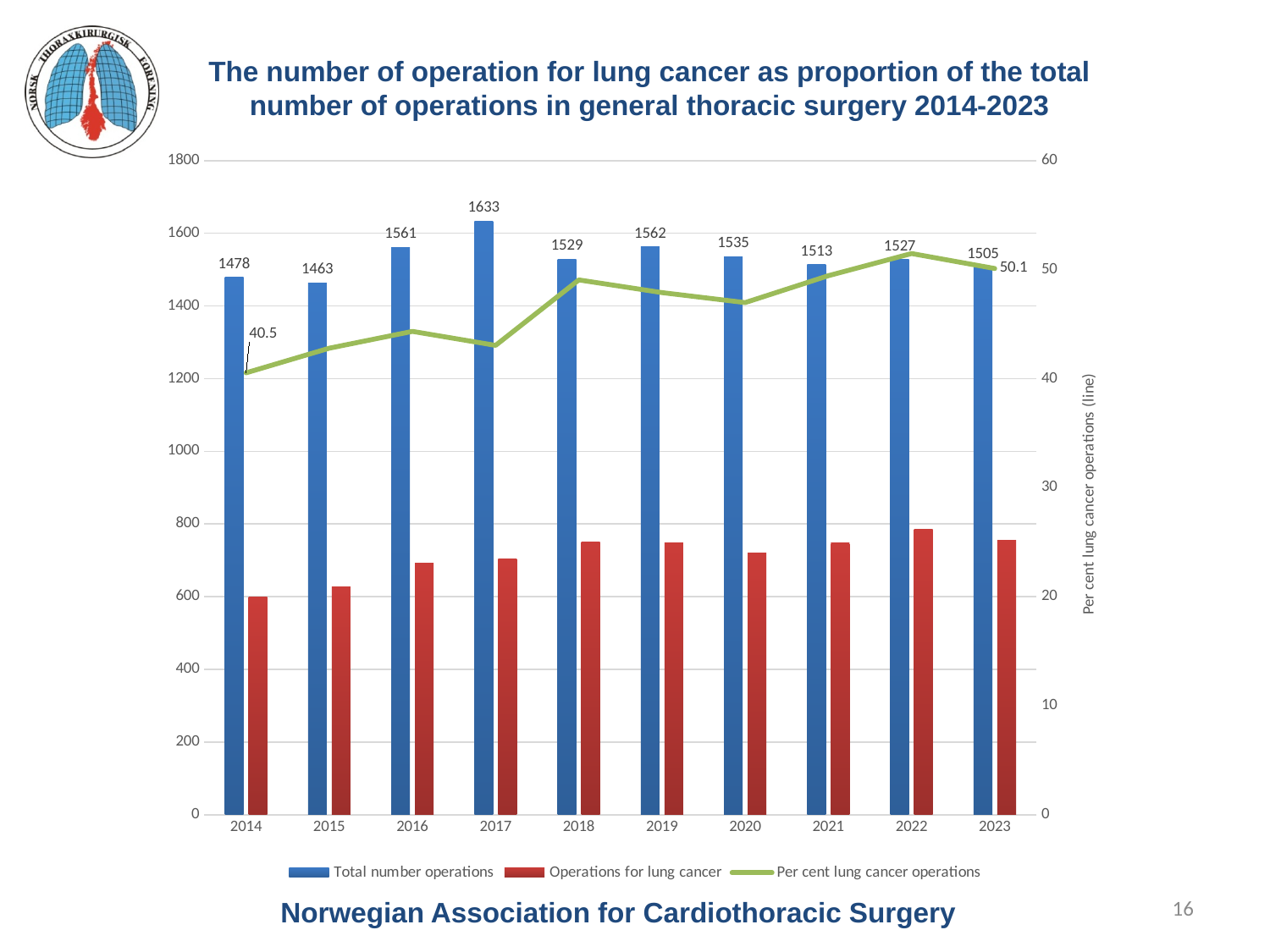
Which year had the lowest total number of operations? 2015 What was the total number of operations in 2017? 1633 Is the number of operations for lung cancer in 2022 greater or less than 600? greater How many series does the legend list? 3 How many years are shown on the x axis? 10 What is the difference between the total number of operations in 2017 and in 2014? 155 What per cent of operations were for lung cancer in 2023? 50.1 Which series is plotted as a line rather than bars? Per cent lung cancer operations Which year had the highest total number of operations? 2017 What was the total number of operations in 2023? 1505 What per cent of operations were for lung cancer in 2014? 40.5 Which year had more total operations, 2016 or 2019? 2019